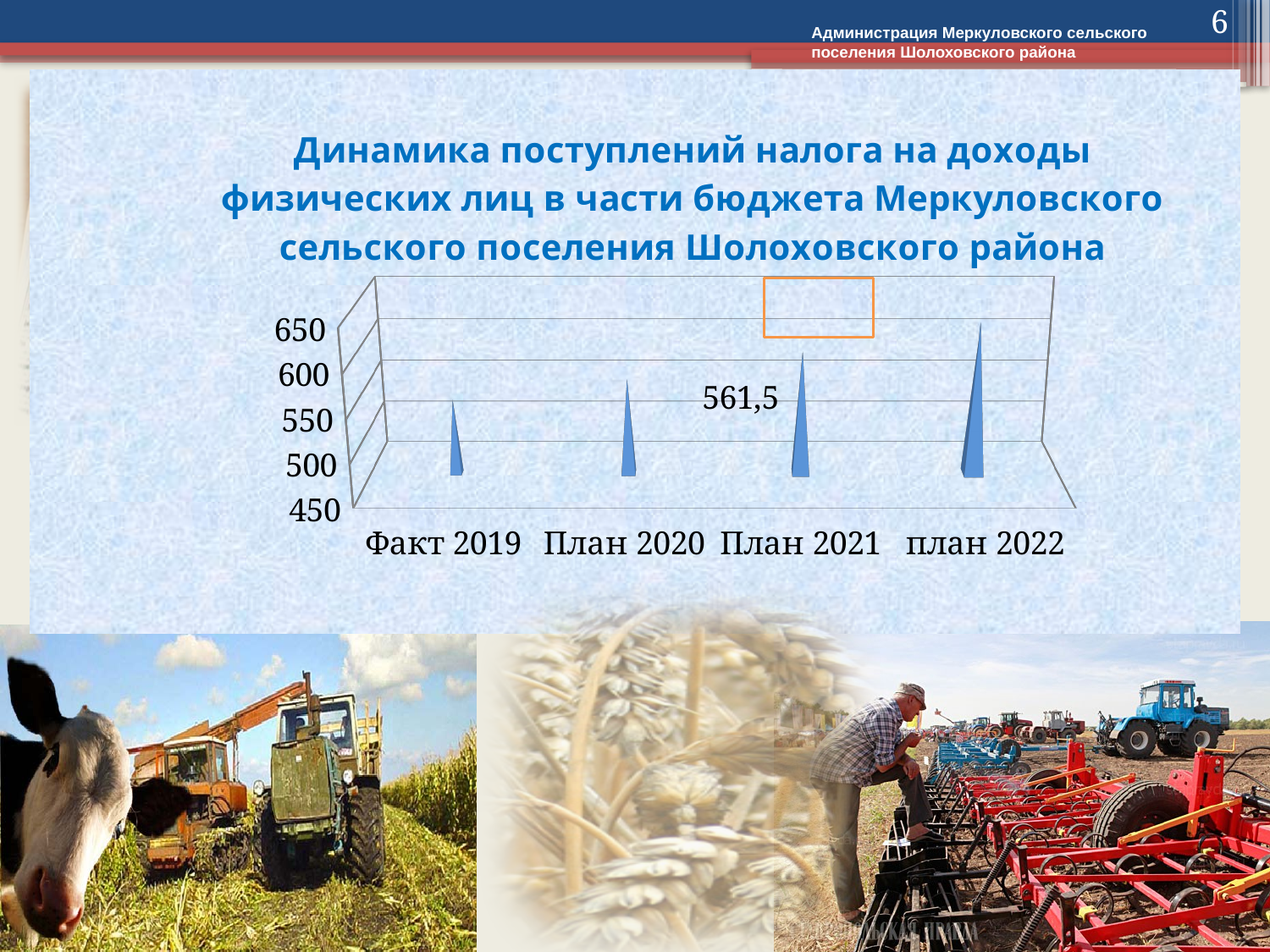
What is the lowest tick value shown on the vertical axis of the chart? 450 Which category has the lowest value in the chart? Факт 2019 What kind of chart is shown on the slide? bar chart Which is larger, the value for план 2022 or the value for Факт 2019? план 2022 Which category has the highest value in the chart? план 2022 Do the values rise or fall from Факт 2019 to план 2022? rise Which is larger, the value for План 2021 or the value for План 2020? План 2021 How many categories are shown on the x axis of the chart? 4 Is the value for план 2022 greater or less than 500? greater What is the only data label printed on the chart? 561,5 Is the value for Факт 2019 greater or less than 600? less